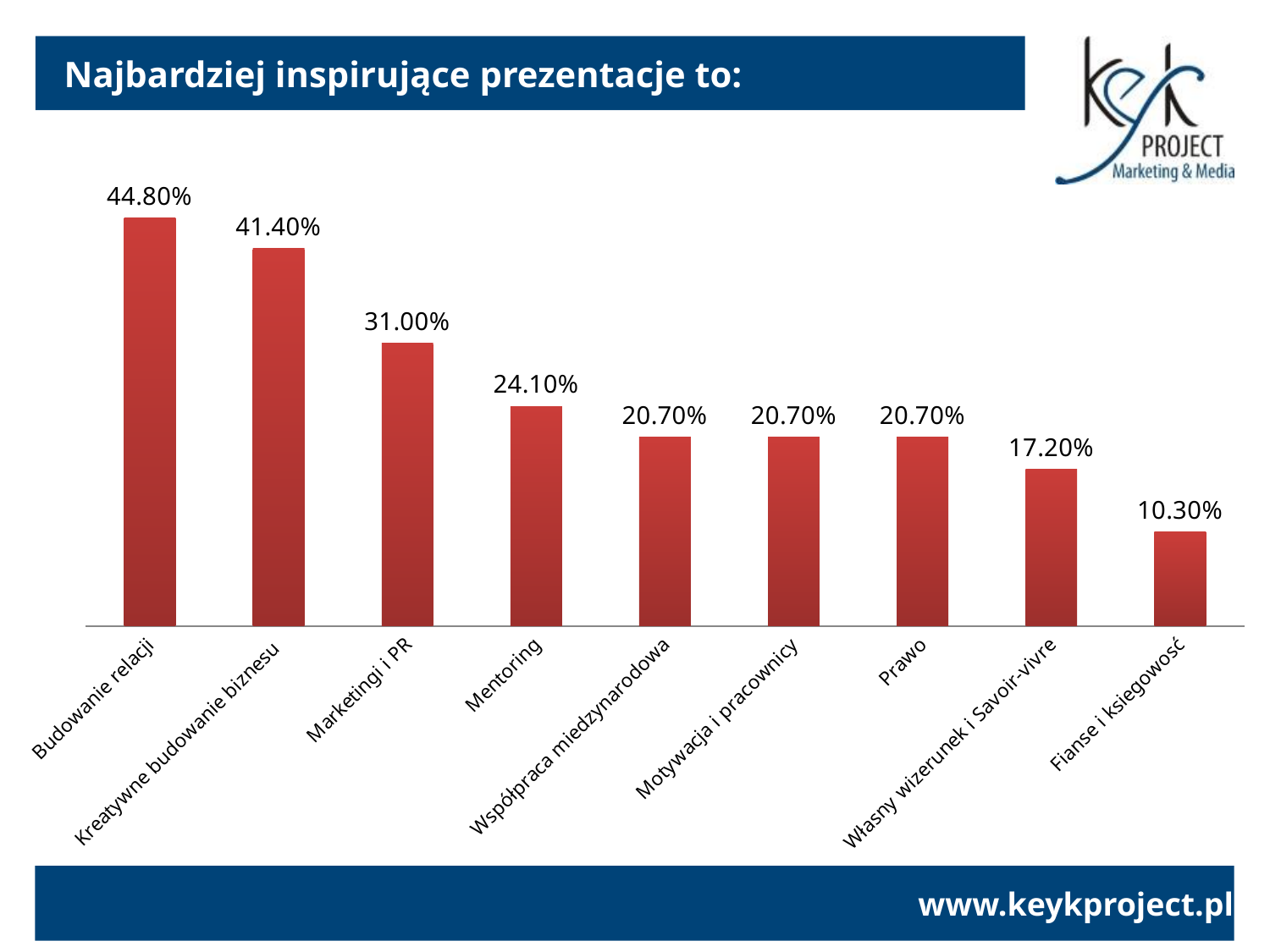
Which category has the highest value? Budowanie relacji Which is larger, the value for Marketingi i PR or the value for Mentoring? Marketingi i PR Do the values rise or fall from left to right along the x axis? Fall How many categories are shown in the chart? 9 What is the difference between the values for Marketingi i PR and Fianse i ksiegowosć? 20.70% What is the title of the slide? Najbardziej inspirujące prezentacje to: What is the value for Budowanie relacji? 44.80% What is the difference between the values for Budowanie relacji and Kreatywne budowanie biznesu? 3.40% Which category has the lowest value? Fianse i ksiegowosć What is the value for Mentoring? 24.10% What kind of chart is shown on the slide? Bar chart What is the value for Własny wizerunek i Savoir-vivre? 17.20%